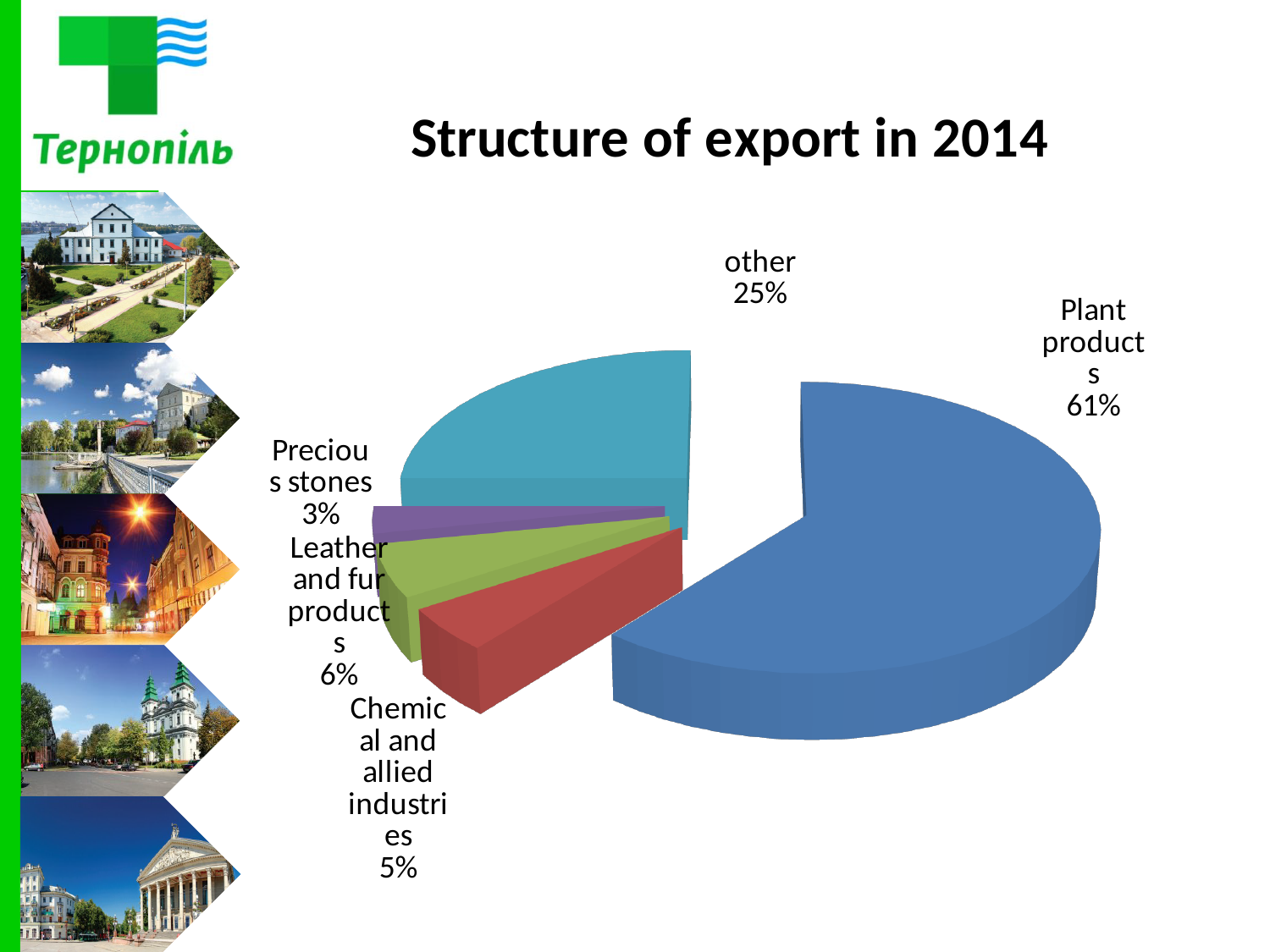
What is the title of the chart? Structure of export in 2014 How many slices does the pie chart have? 5 What is the difference in percentage points between Plant products and other? 36 What share of export is Chemical and allied industries? 5% Which category has the largest share of export? Plant products What share of export is labelled other? 25% What share of export is Plant products? 61% What share of export is Precious stones? 3% Which is larger, the share for Leather and fur products or for Chemical and allied industries? Leather and fur products Which category has the smallest share of export? Precious stones What kind of chart is shown on the slide? pie chart What share of export is Leather and fur products? 6%